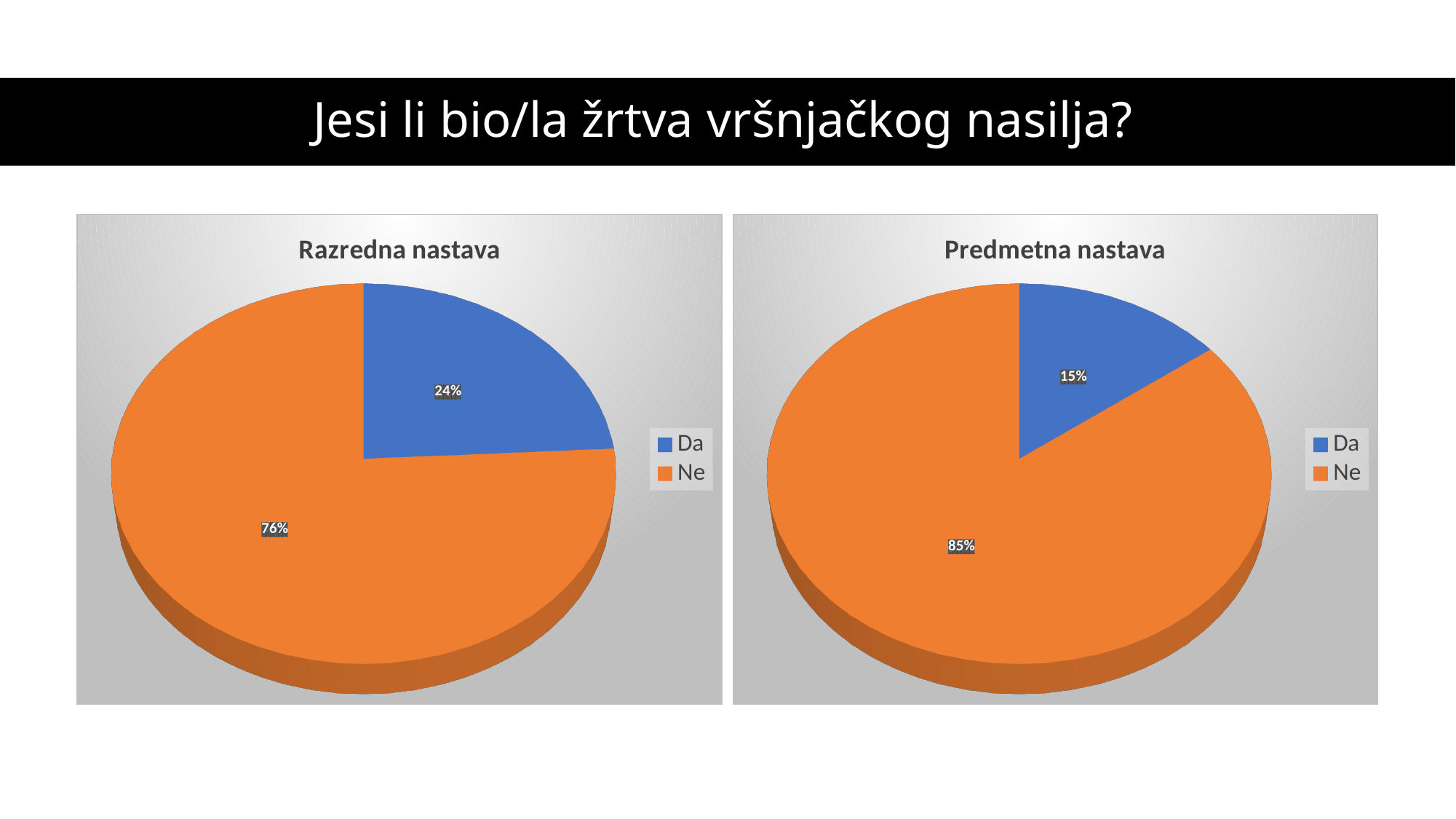
How many categories does the legend of the 'Predmetna nastava' chart list? 2 In the 'Predmetna nastava' chart, what is the difference between the 'Ne' and 'Da' percentages? 70% In the 'Razredna nastava' chart, what percentage is shown for 'Ne'? 76% In the 'Predmetna nastava' chart, what percentage is shown for 'Ne'? 85% In the 'Razredna nastava' chart, which category has the largest slice? Ne In the 'Predmetna nastava' chart, what percentage is shown for 'Da'? 15% Is the 'Da' share larger in the 'Razredna nastava' chart or the 'Predmetna nastava' chart? Razredna nastava In the 'Predmetna nastava' chart, which category has the smallest slice? Da In the 'Razredna nastava' chart, what percentage is shown for 'Da'? 24% In the 'Predmetna nastava' chart, what colour is the 'Ne' slice? Orange In the 'Razredna nastava' chart, what is the difference between the 'Ne' and 'Da' percentages? 52% What type of chart is the 'Razredna nastava' chart? Pie chart